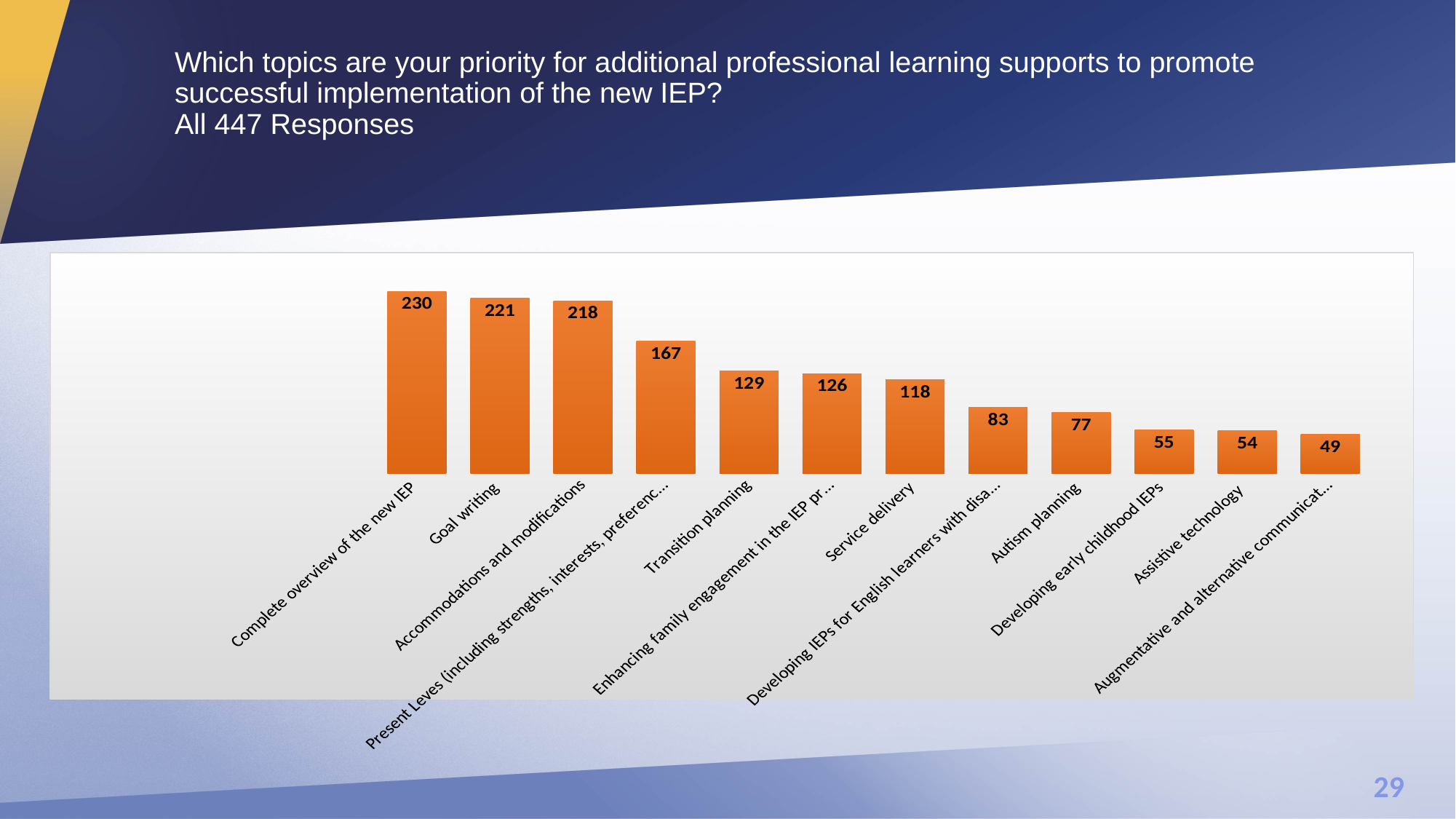
What is the value for Assistive technology? 54 What is the value for Transition planning? 129 How many categories are shown in the chart? 12 Which category has the highest value? Complete overview of the new IEP Do the values rise or fall from left to right along the x axis? Fall Which category has the lowest value? Augmentative and alternative communicat... What kind of chart is shown on the slide? Bar chart Which is larger, the value for Accommodations and modifications or the value for Transition planning? Accommodations and modifications What is the difference between the values for Complete overview of the new IEP and Goal writing? 9 What is the difference between the values for Autism planning and Developing early childhood IEPs? 22 What is the value for Service delivery? 118 What is the value for Goal writing? 221